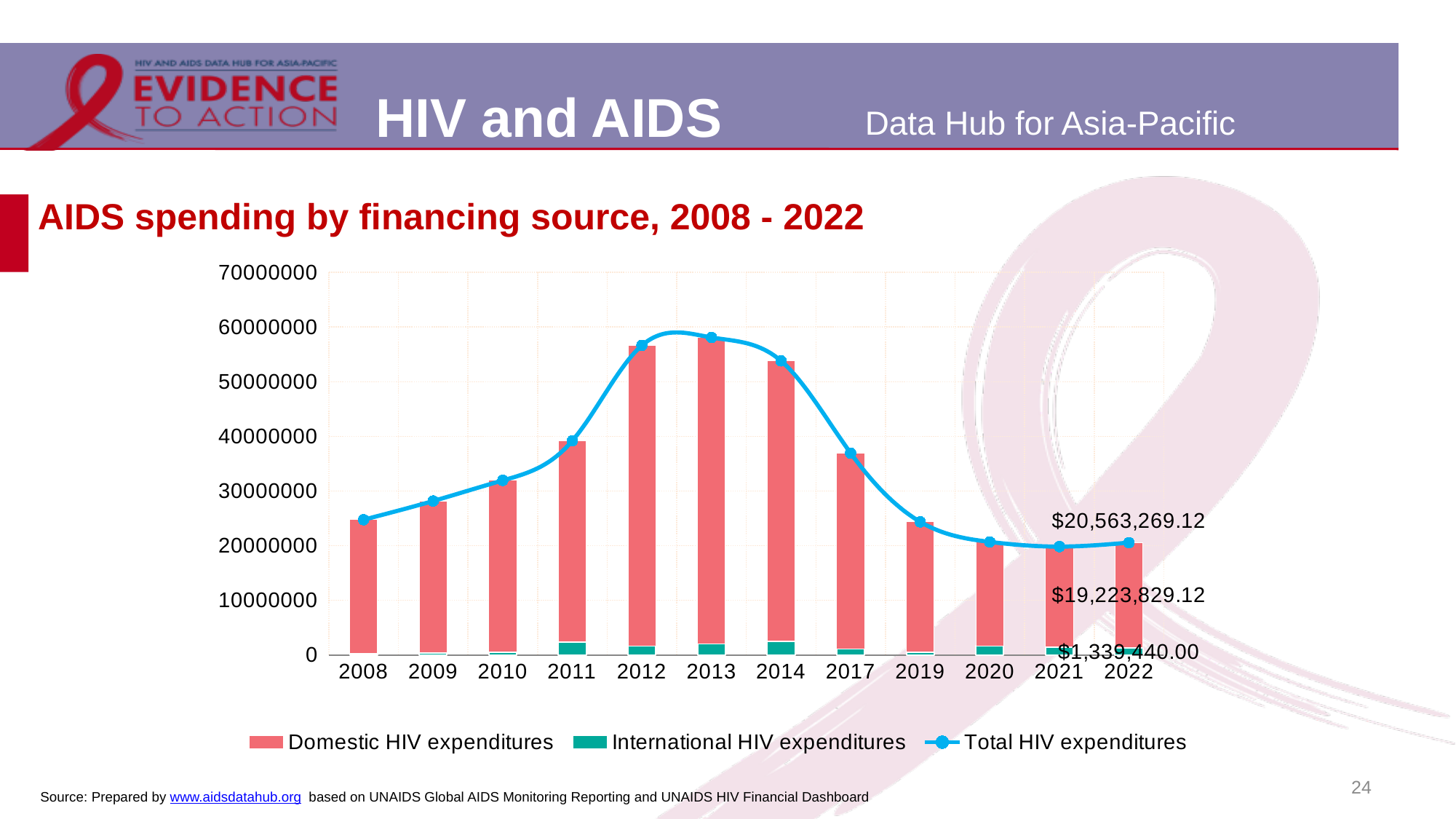
How many series does the legend list? 3 How many years are shown on the x axis of the chart? 12 What is the Total HIV expenditures value labelled for 2022? $20,563,269.12 Does Total HIV expenditures rise or fall from 2014 to 2021? fall What is the Domestic HIV expenditures value labelled for 2022? $19,223,829.12 In 2022, how much larger is Domestic HIV expenditures than International HIV expenditures? $17,884,389.12 What is the title of the chart? AIDS spending by financing source, 2008 - 2022 Is the Total HIV expenditures value for 2008 greater or less than 30000000? less What kind of chart is shown on the slide? Stacked bar chart with a line What is the International HIV expenditures value labelled for 2022? $1,339,440.00 Which year has the larger Total HIV expenditures, 2010 or 2012? 2012 Is the Total HIV expenditures value for 2014 greater or less than 50000000? greater